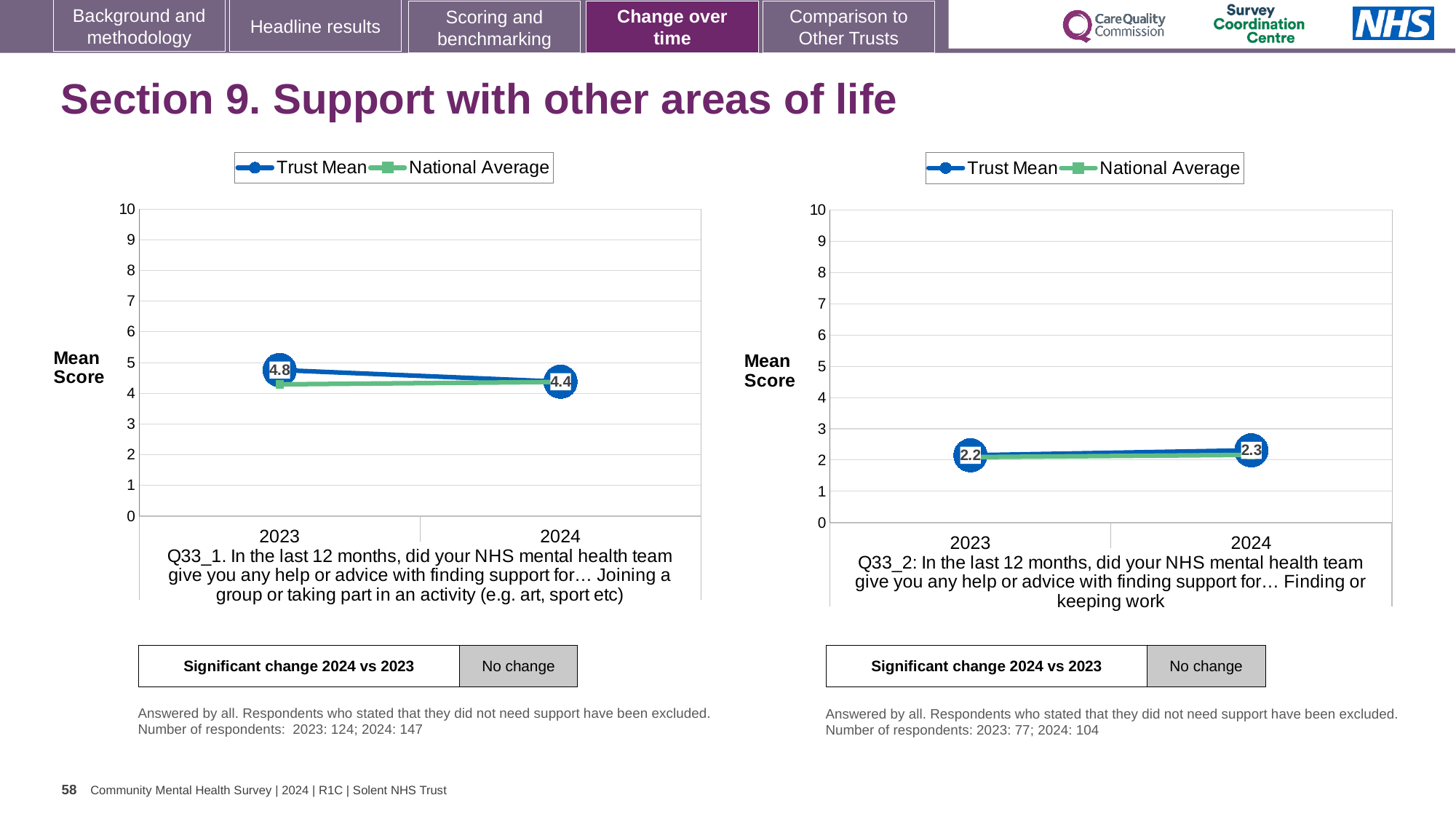
In the left chart (Q33_1), which year has the higher Trust Mean, 2023 or 2024? 2023 In the right chart (Q33_2), what is the difference between the Trust Mean for 2024 and 2023? 0.1 In the right chart (Q33_2), what is the Trust Mean score for 2023? 2.2 How many series does the legend of the right chart (Q33_2) list? 2 In the left chart (Q33_1), what is the Trust Mean score for 2024? 4.4 In the left chart (Q33_1), is the National Average value for 2023 greater or less than 5? less In the left chart (Q33_1), does the Trust Mean rise or fall from 2023 to 2024? fall In the left chart (Q33_1), what is the Trust Mean score for 2023? 4.8 In the right chart (Q33_2), does the Trust Mean rise or fall from 2023 to 2024? rise What kind of chart is the left chart (Q33_1)? line chart In the left chart (Q33_1), by how much did the Trust Mean change from 2023 to 2024? 0.4 In the right chart (Q33_2), what is the Trust Mean score for 2024? 2.3